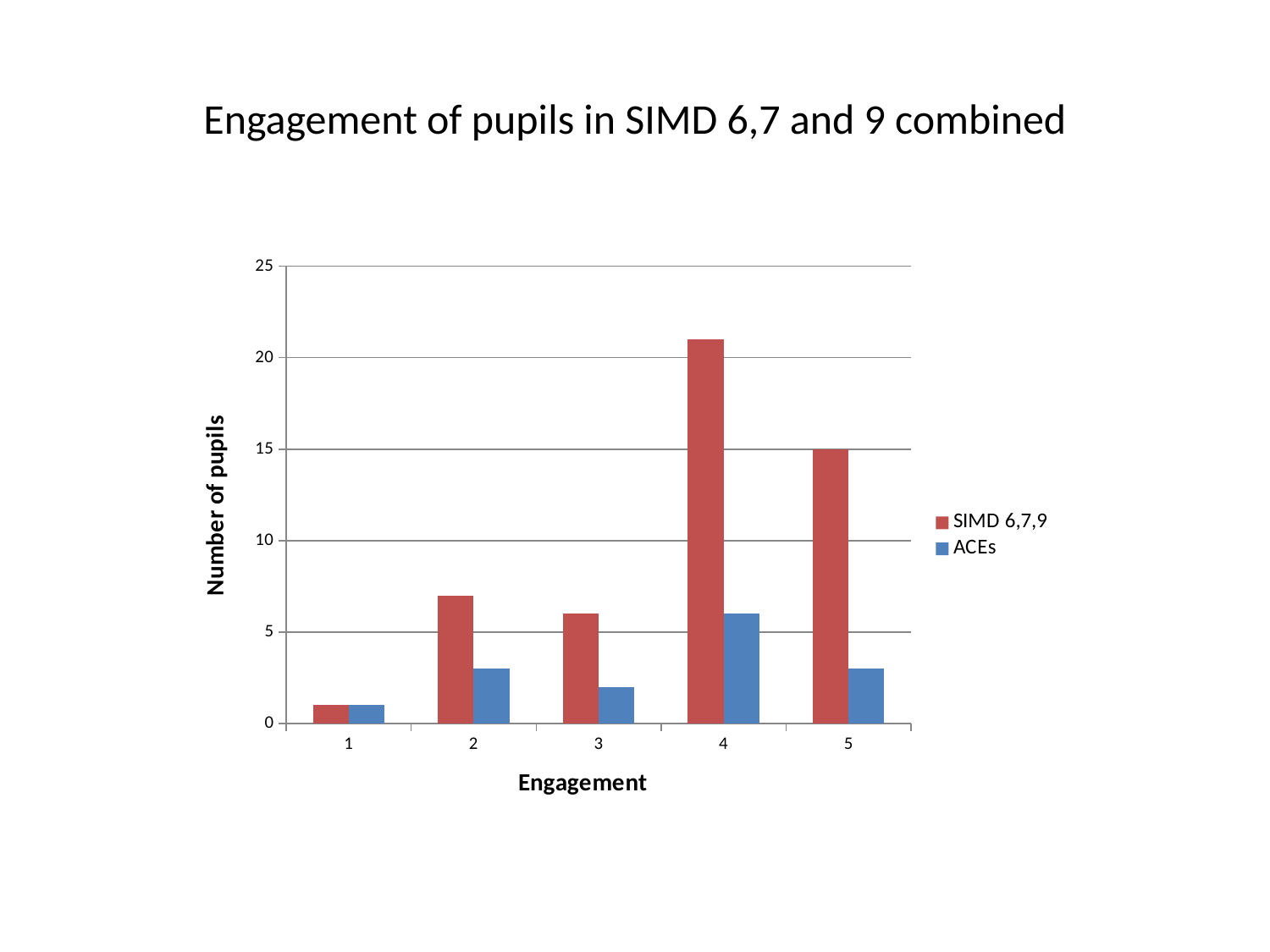
What is the title of the chart? Engagement of pupils in SIMD 6,7 and 9 combined Is the value for SIMD 6,7,9 at engagement level 2 greater or less than 5? greater Is the value for ACEs at engagement level 2 greater or less than 5? less How many engagement categories are shown on the x axis? 5 Which engagement level has the highest number of pupils for ACEs? 4 Is the value for SIMD 6,7,9 at engagement level 4 greater or less than 20? greater Which engagement level has the lowest number of pupils for SIMD 6,7,9? 1 What kind of chart is shown on the slide? bar chart Which engagement level has the highest number of pupils for SIMD 6,7,9? 4 At engagement level 4, which series has the larger value, SIMD 6,7,9 or ACEs? SIMD 6,7,9 How many series does the legend list? 2 What is the number of pupils for SIMD 6,7,9 at engagement level 5? 15